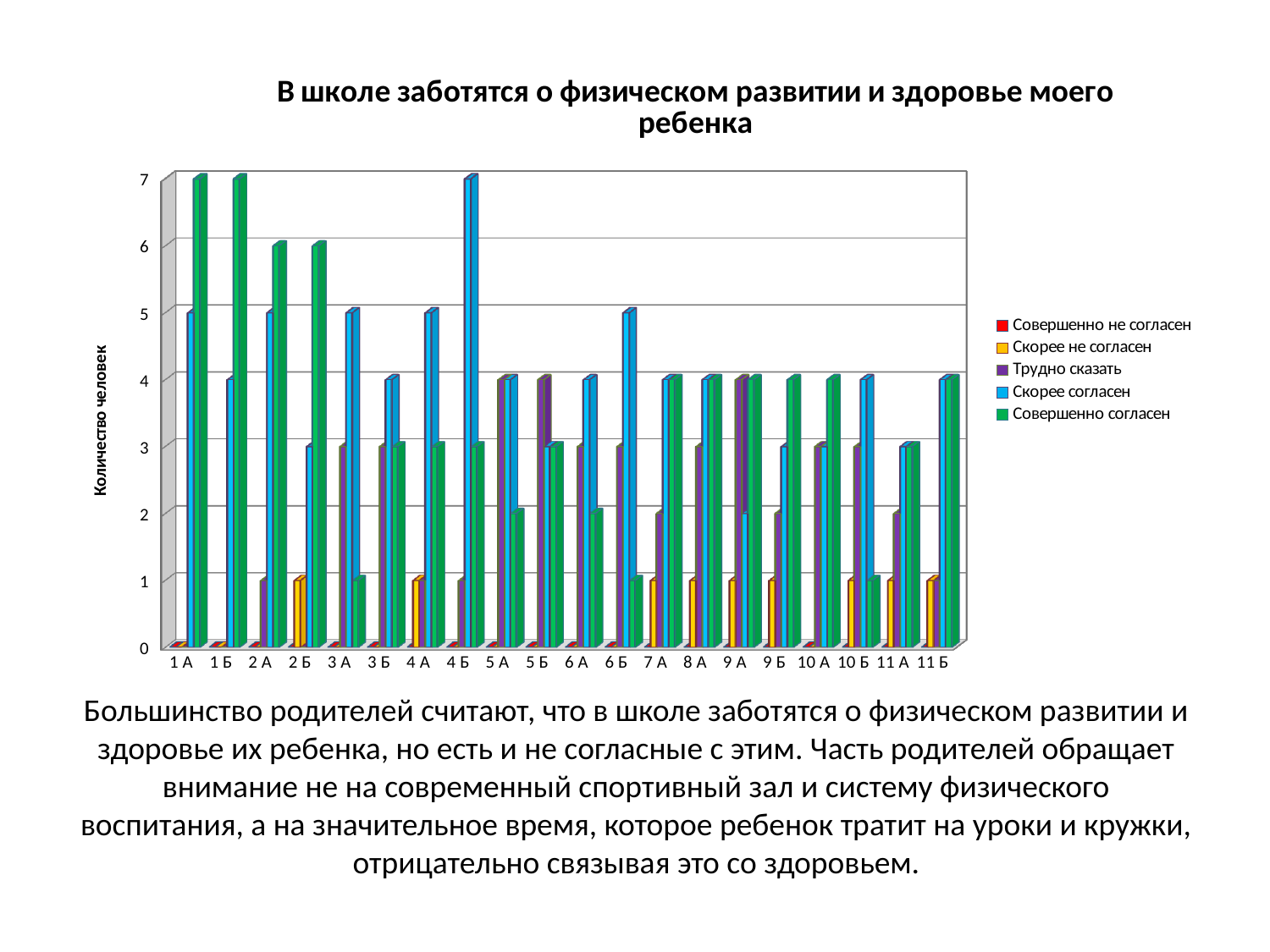
What kind of chart is shown on the slide? bar chart How many series does the legend list? 5 How many classes (categories) are shown along the x axis? 20 Which class has the larger value for "Совершенно согласен": 1 А or 3 А? 1 А Is the value of "Совершенно согласен" for 3 А greater or less than 3? less What is the label of the vertical axis? Количество человек Is the value of "Скорее согласен" for 4 Б greater or less than 5? greater Which series is shown in green in the legend? Совершенно согласен What is the title of the chart? В школе заботятся о физическом развитии и здоровье моего ребенка Is the value of "Совершенно согласен" for 1 А greater or less than 5? greater For class 4 Б, which is larger: "Скорее согласен" or "Совершенно согласен"? Скорее согласен